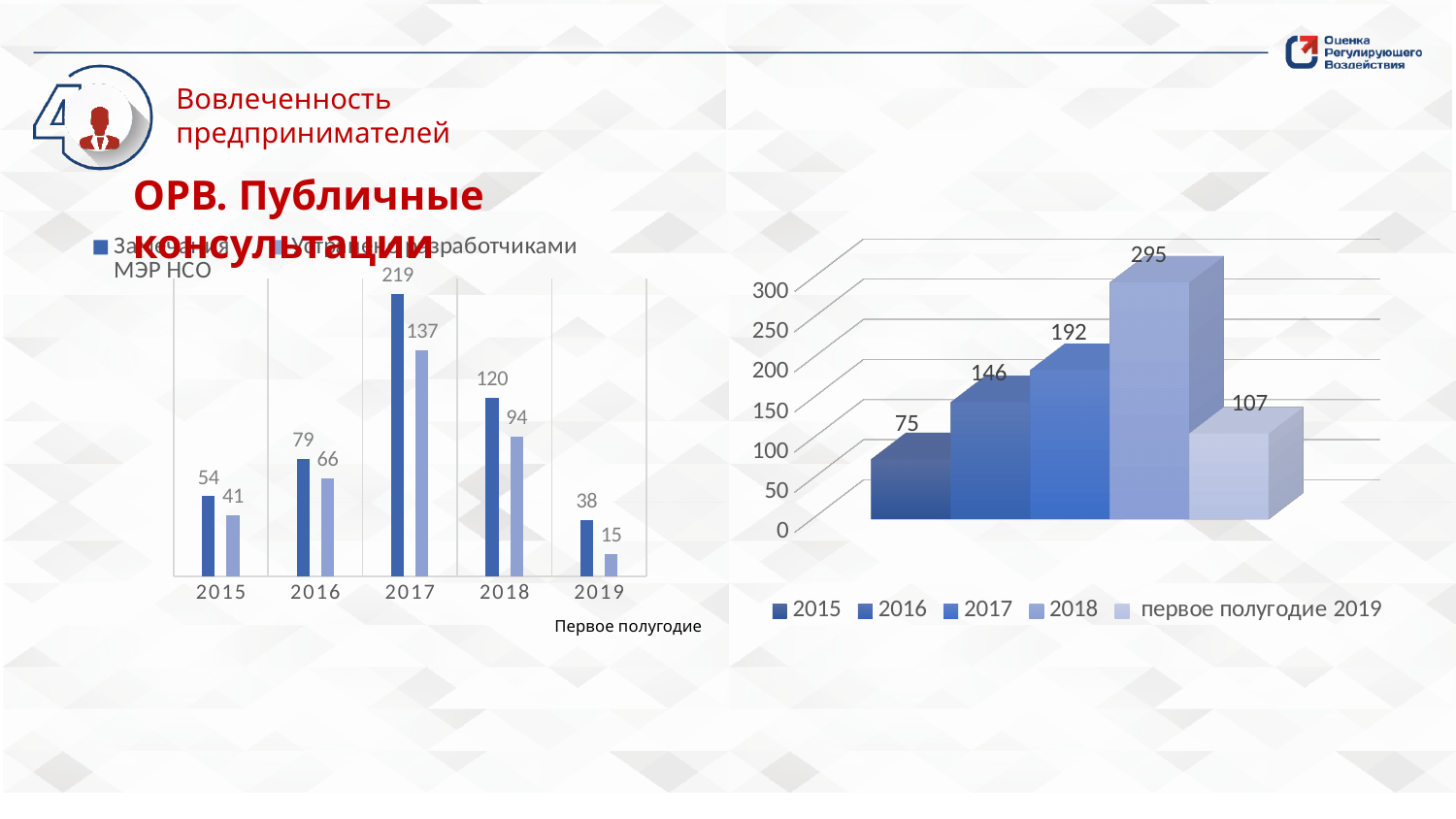
In the right chart, what is the value for 2018? 295 In the left chart, which year has the highest darker blue bar? 2017 How many entries does the legend of the right chart list? 5 In the right chart, which category has the lowest value? 2015 In the right chart, what is the value for 2015? 75 In the left chart, what is the difference between the darker blue and lighter blue bars for 2018? 26 In the left chart, what is the value of the lighter blue bar for 2019? 15 In the right chart, do the values rise or fall from 2015 to 2018? rise How many years are shown on the x axis of the left chart? 5 In the right chart, which year has the highest value? 2018 In the left chart, what is the value of the darker blue bar for 2017? 219 In the right chart, what is the difference between the values for 2017 and 2016? 46